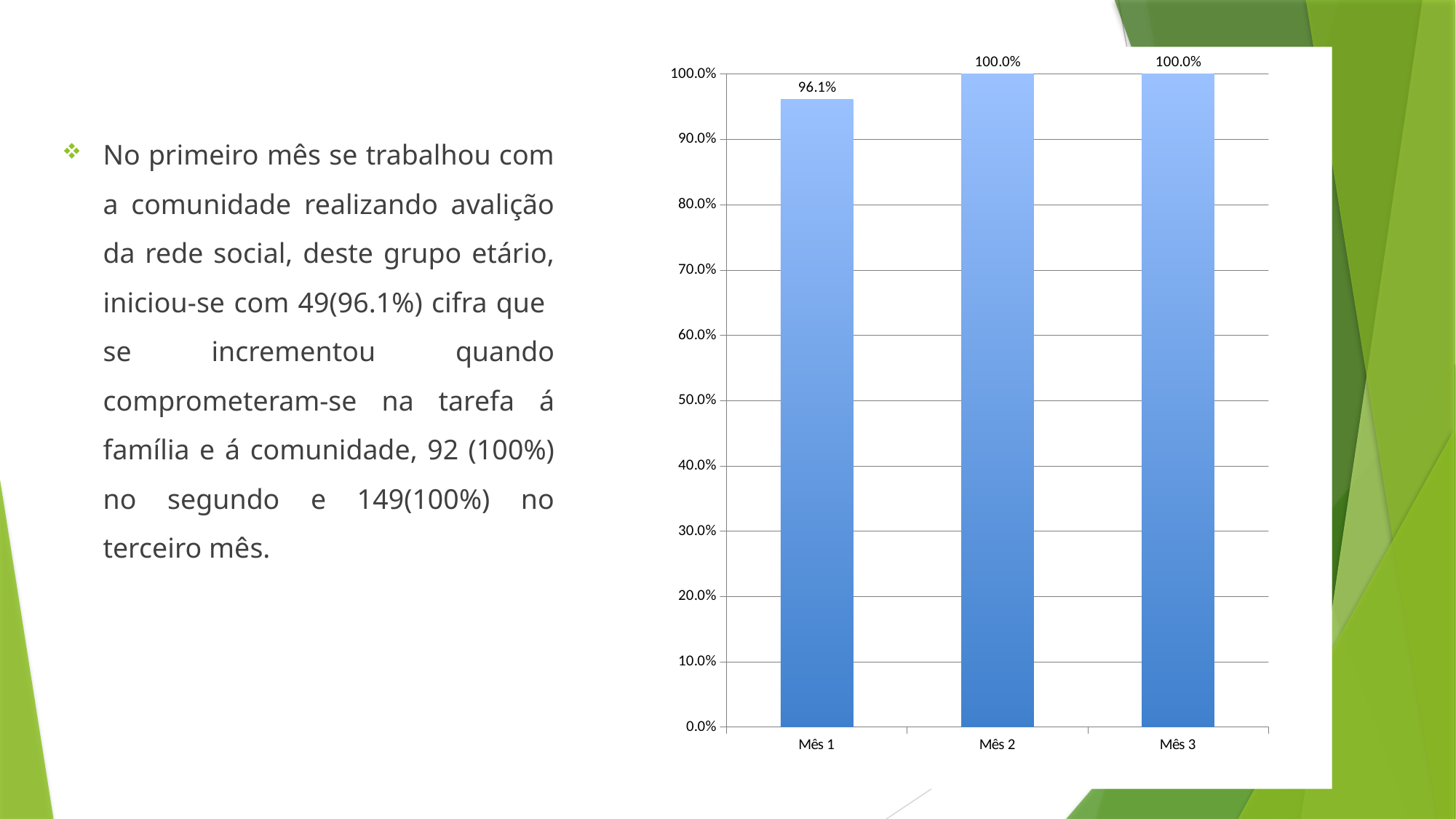
What is the value for Mês 1? 96.1% Which is larger, the value for Mês 1 or the value for Mês 3? Mês 3 What is the value for Mês 2? 100.0% What is the difference between the values for Mês 2 and Mês 1? 3.9% Do the values rise or fall from Mês 1 to Mês 2? rise How many categories are shown on the x axis? 3 Which category has the lowest value? Mês 1 Is the value for Mês 1 greater or less than 90.0%? greater What is the highest value shown on the y axis? 100.0% What is the value for Mês 3? 100.0% What kind of chart is shown on the slide? bar chart What colour are the bars in the chart? blue